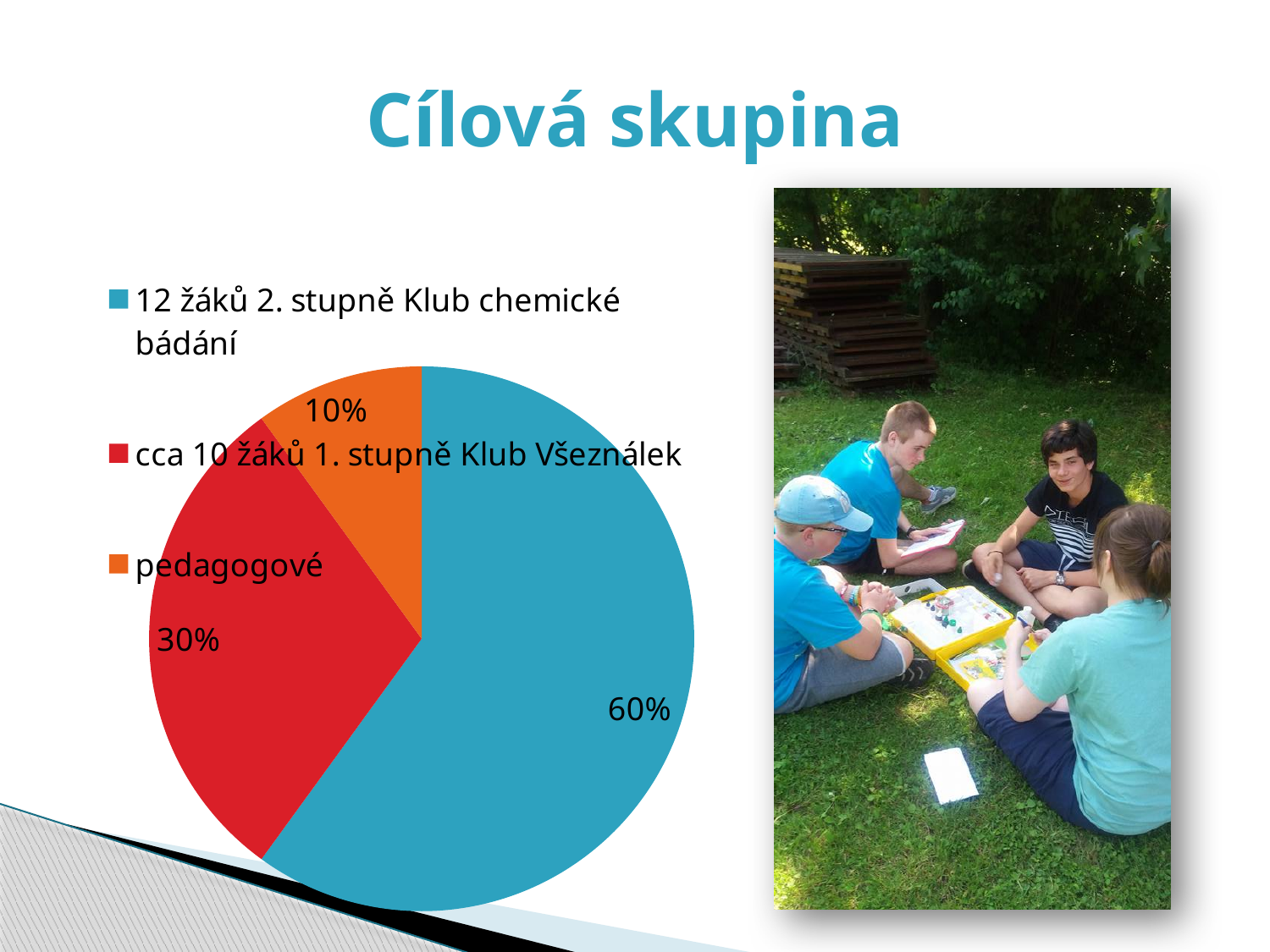
Which category has the largest slice of the pie? 12 žáků 2. stupně Klub chemické bádání What share of the pie does the slice for "cca 10 žáků 1. stupně Klub Všeználek" represent? 30% What is the difference in percentage points between the slice for "12 žáků 2. stupně Klub chemické bádání" and the slice for "cca 10 žáků 1. stupně Klub Všeználek"? 30% What share of the pie does the slice for "12 žáků 2. stupně Klub chemické bádání" represent? 60% Which category has the smallest slice of the pie? pedagogové What colour is the slice for "pedagogové"? orange What share of the pie does the slice for "pedagogové" represent? 10% What is the difference in percentage points between the slice for "cca 10 žáků 1. stupně Klub Všeználek" and the slice for "pedagogové"? 20% What is the title of the slide containing the pie chart? Cílová skupina What kind of chart is shown on the slide? pie chart Which slice is larger: "cca 10 žáků 1. stupně Klub Všeználek" or "pedagogové"? cca 10 žáků 1. stupně Klub Všeználek How many slices does the pie chart have? 3